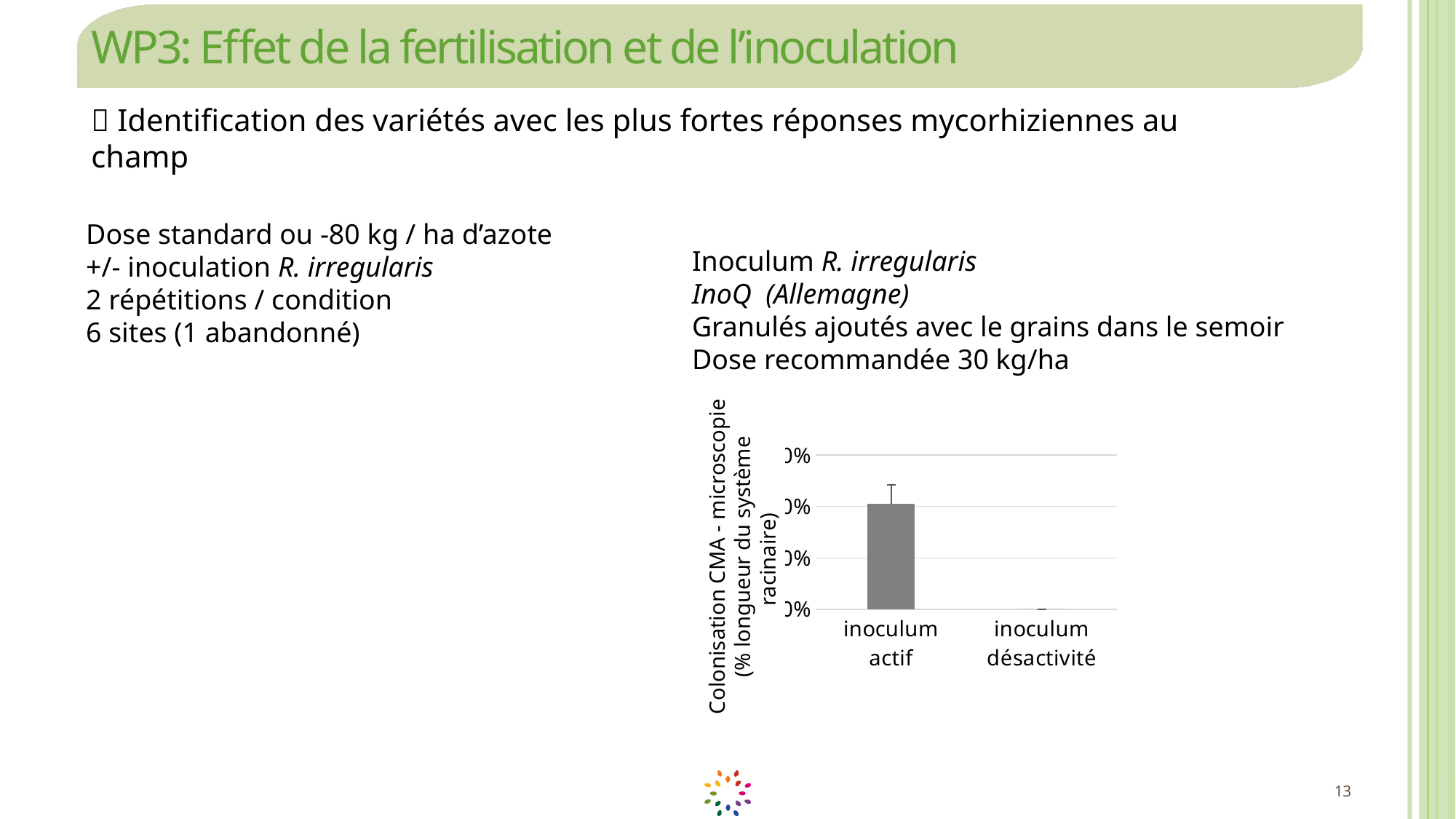
Which is larger, the value for inoculum actif or the value for inoculum désactivité? inoculum actif What kind of chart is shown on the slide? bar chart Which category has the highest value in the chart? inoculum actif What are the two category labels on the x axis of the chart? inoculum actif, inoculum désactivité How many categories are shown on the x axis of the chart? 2 What is the title of the y axis of the chart? Colonisation CMA - microscopie (% longueur du système racinaire) Which category has the lowest value in the chart? inoculum désactivité